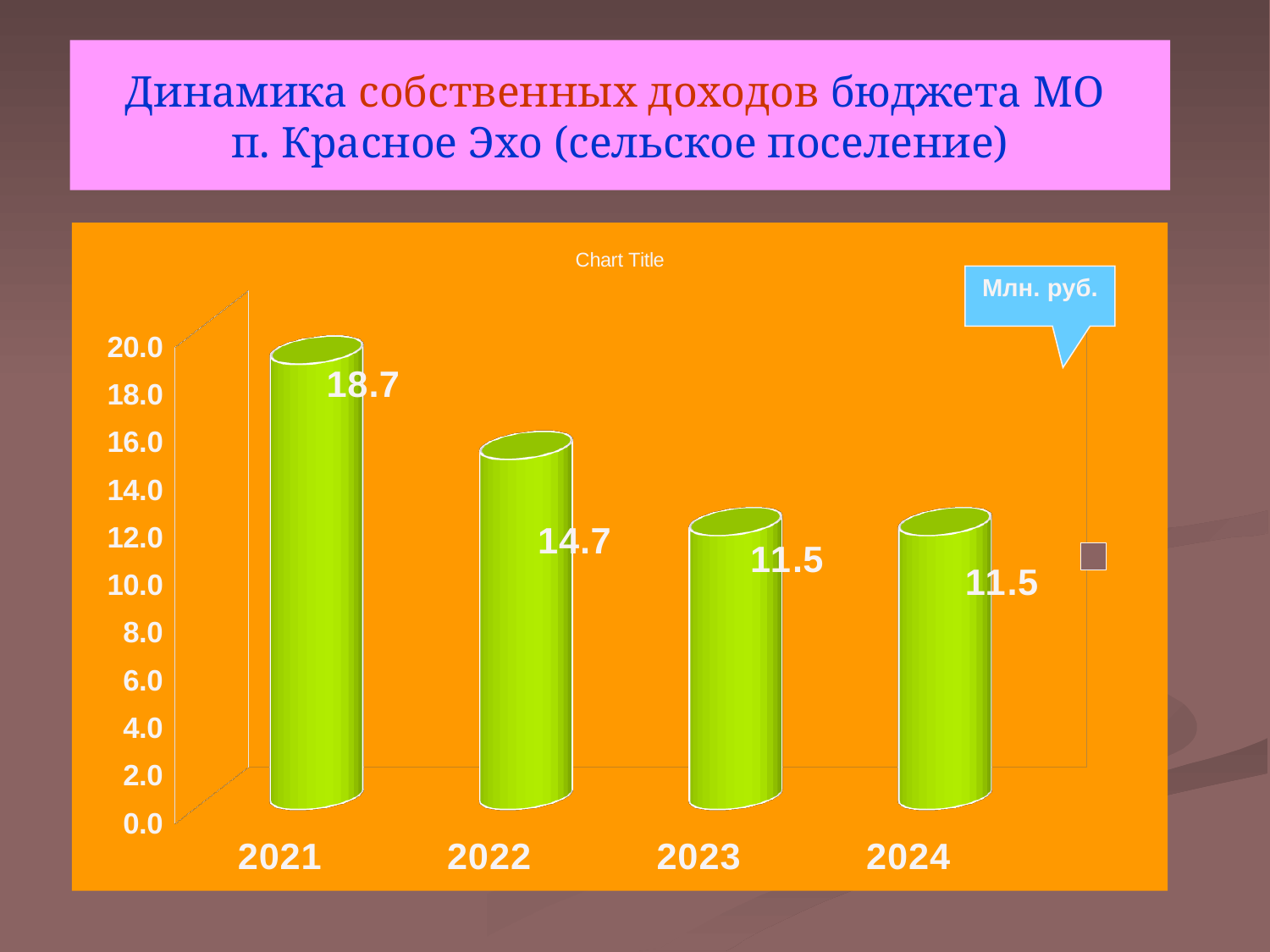
What is the difference between the values for 2022 and 2023? 3.2 How many years are shown on the x axis? 4 What is the value for 2022? 14.7 Do the values generally rise or fall from 2021 to 2024? fall Which is larger, the value for 2021 or the value for 2022? 2021 What kind of chart is shown on the slide? bar chart Is the value for 2022 greater or less than 14.0? greater Which year has the highest value? 2021 What is the value for 2024? 11.5 What is the value for 2023? 11.5 What is the difference between the values for 2021 and 2022? 4.0 What is the value for 2021? 18.7